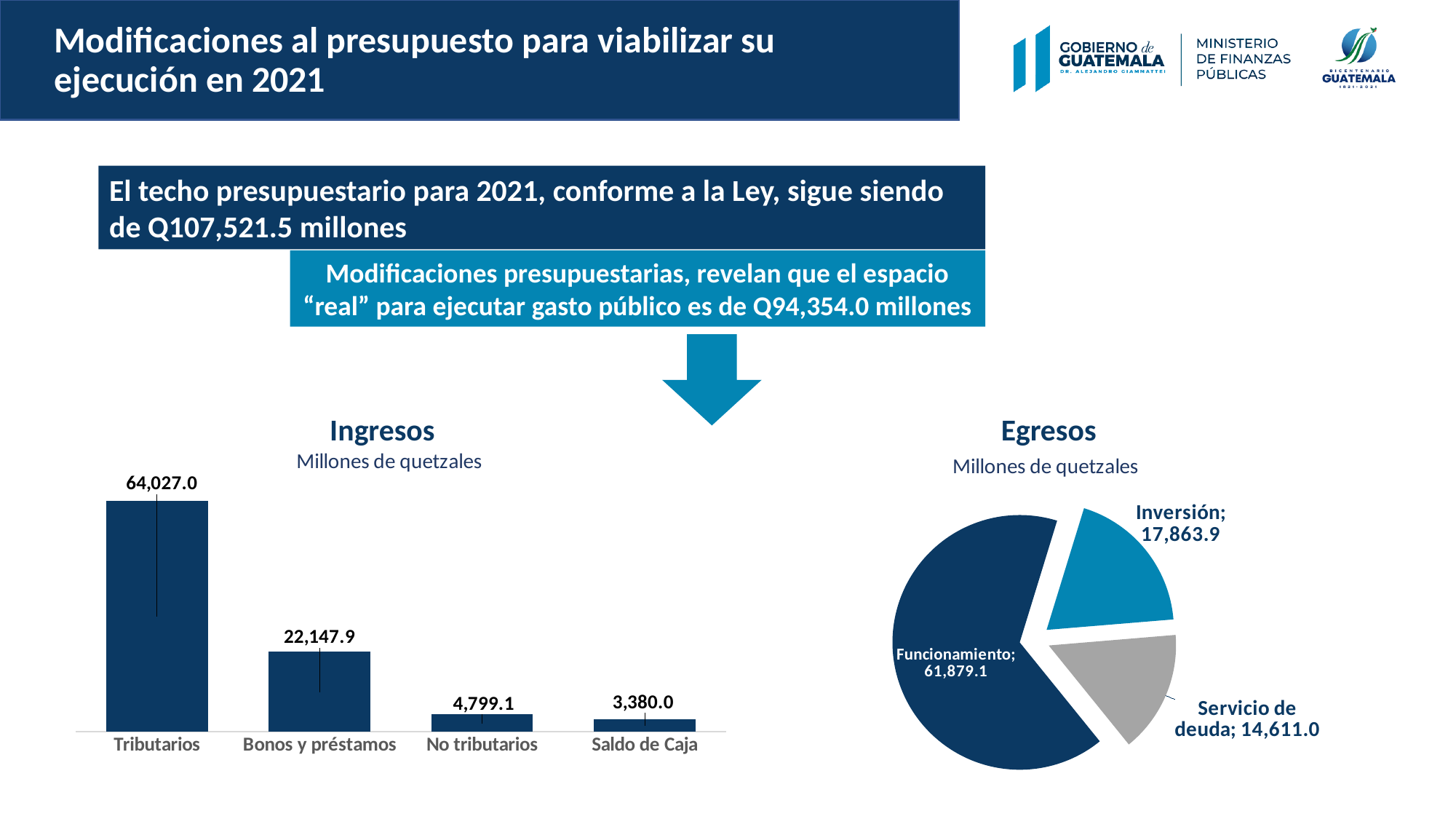
In the Ingresos bar chart, what is the difference between Tributarios and Bonos y préstamos? 41,879.1 In the Ingresos bar chart, what is the value for Bonos y préstamos? 22,147.9 In the Egresos pie chart, which slice is the largest? Funcionamiento In the Ingresos bar chart, which category has the lowest value? Saldo de Caja In the Egresos pie chart, what is the value for Servicio de deuda? 14,611.0 In the Ingresos bar chart, what is the value for Tributarios? 64,027.0 In the Egresos pie chart, what share of the total does Funcionamiento represent? 65.6% In the Ingresos bar chart, which category has the highest value? Tributarios In the Ingresos bar chart, how many categories are shown? 4 In the Egresos pie chart, which is larger: Inversión or Servicio de deuda? Inversión What type of chart is the Ingresos chart? Bar chart What unit is stated under the Egresos chart title? Millones de quetzales